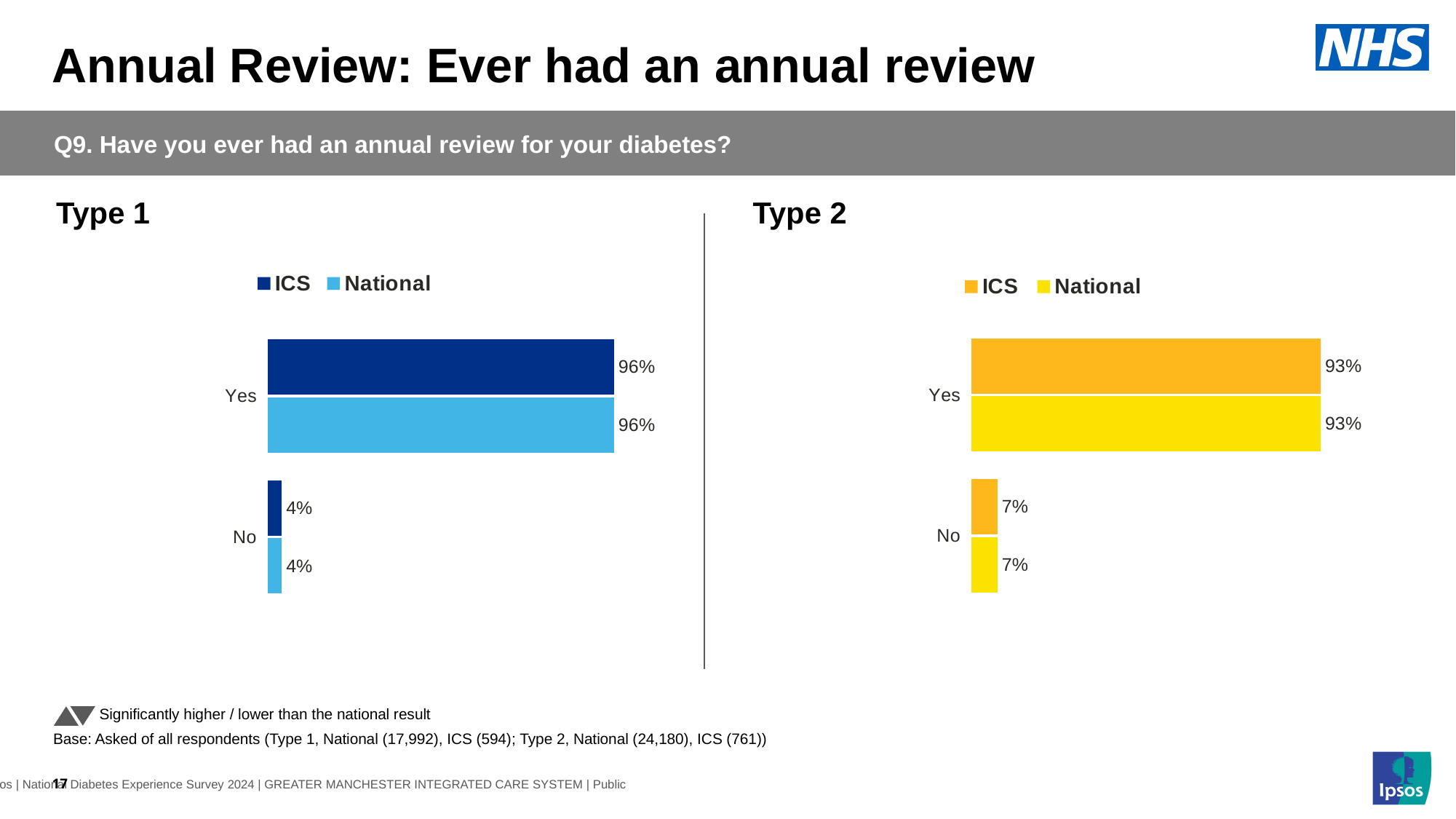
Which is larger: the ICS value for Yes in the Type 1 chart or the ICS value for Yes in the Type 2 chart? Type 1 In the Type 2 chart, which category has the highest ICS value? Yes In the Type 2 chart, what is the National value for No? 7% In the Type 1 chart, what is the difference between the ICS values for Yes and No? 92% In the Type 2 chart, what is the ICS value for Yes? 93% What kind of chart is the Type 1 chart? Bar chart In the Type 1 chart, which category has the lowest National value? No In the Type 1 chart, what is the National value for No? 4% How many series does the legend of the Type 1 chart list? 2 How many categories are shown in the Type 2 chart? 2 In the Type 1 chart, what is the ICS value for Yes? 96% In the Type 2 chart, what is the difference between the National values for Yes and No? 86%